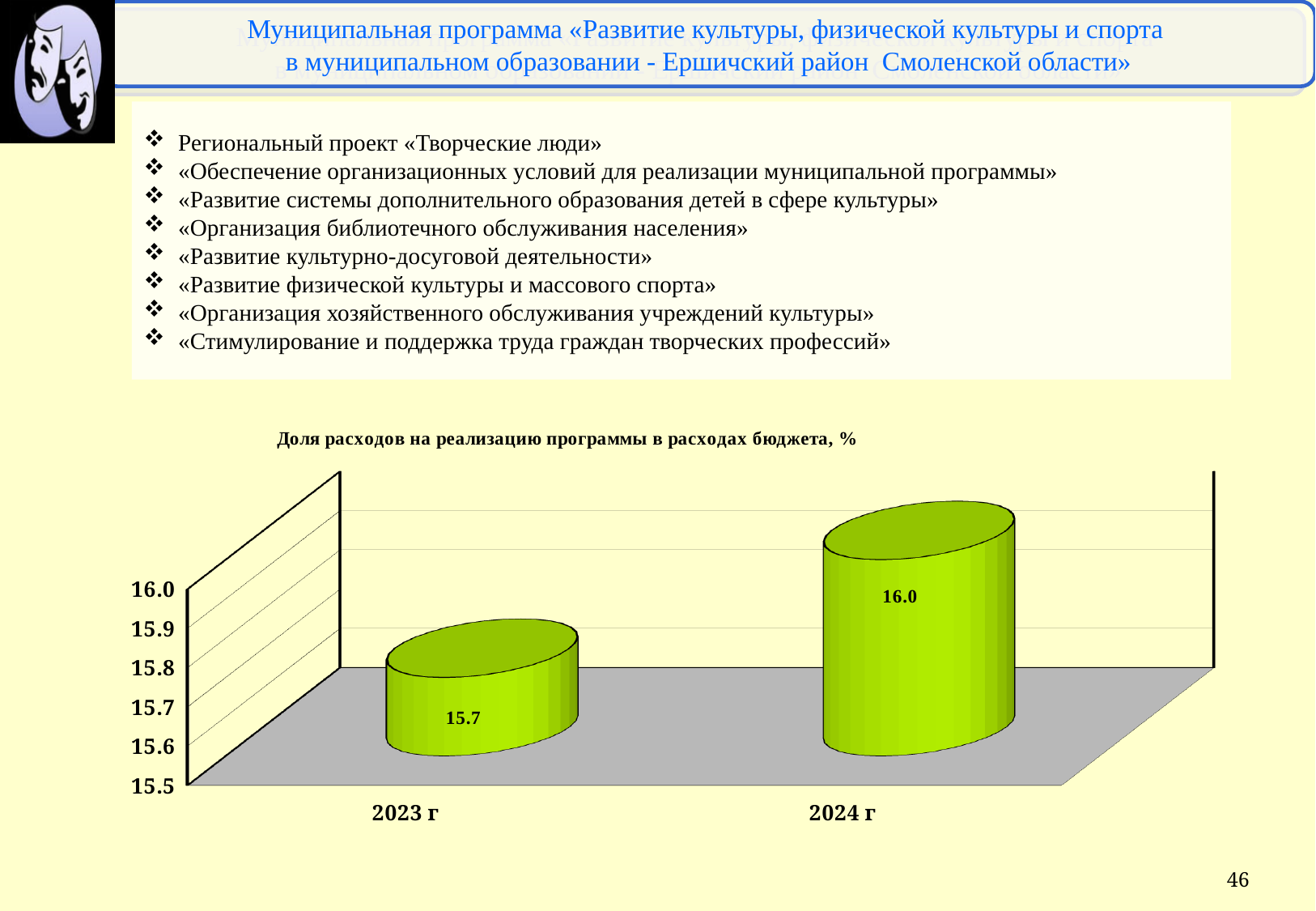
Which year has the lowest value? 2023 г Which is larger, the value for 2023 г or the value for 2024 г? 2024 г What is the title of the chart? Доля расходов на реализацию программы в расходах бюджета, % What is the lowest value shown on the vertical axis? 15.5 Is the value for 2023 г greater or less than 15.9? less What kind of chart is shown on the slide? bar chart What is the difference between the values for 2024 г and 2023 г? 0.3 What is the value for 2024 г? 16.0 Which year has the highest value? 2024 г How many categories are shown on the x axis? 2 What is the value for 2023 г? 15.7 Do the values rise or fall from 2023 г to 2024 г? rise